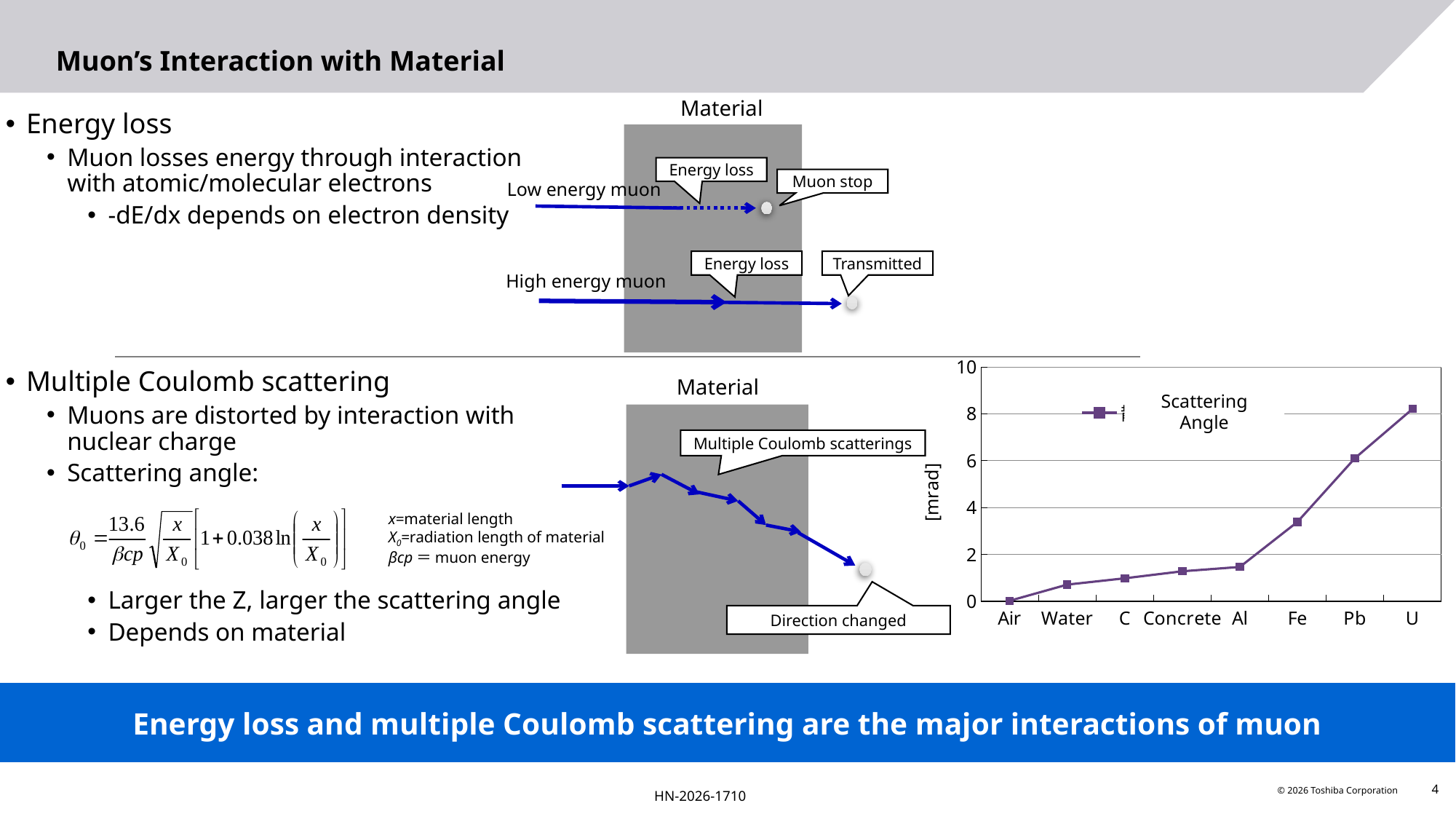
How many series does the legend of the scattering angle chart list? 1 Which material has the lowest scattering angle in the chart? Air What kind of chart is shown on the right side of the slide? line chart Do the scattering angle values rise or fall from Air to U along the x axis? rise Is the scattering angle for Fe greater or less than 4 mrad? less How many materials are plotted along the x axis of the scattering angle chart? 8 Is the scattering angle for Al greater or less than 2 mrad? less What unit is shown on the y axis of the scattering angle chart? [mrad] Which material has the highest scattering angle in the chart? U Which has a larger scattering angle, Pb or Fe? Pb